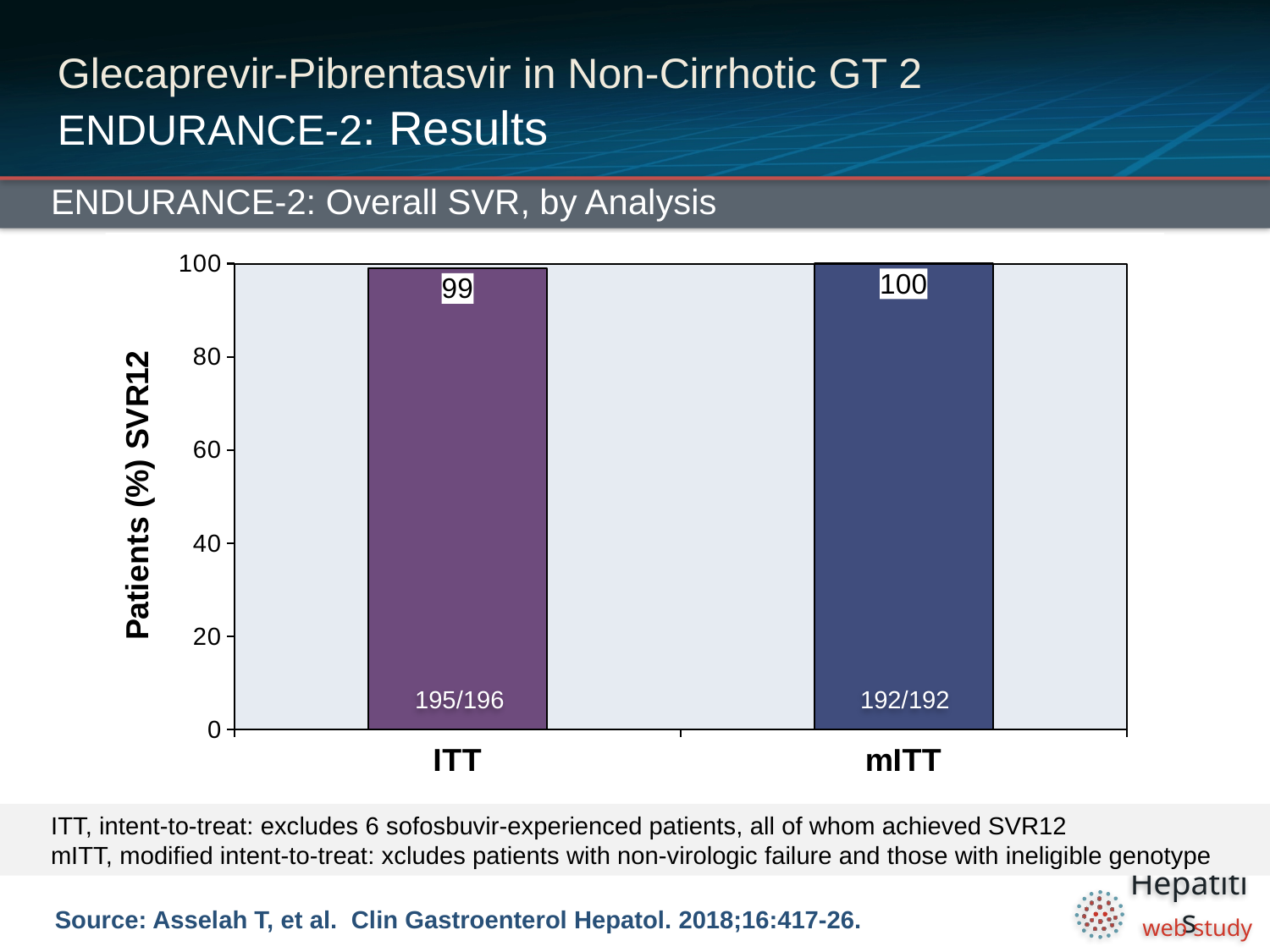
How many categories are shown on the x axis? 2 What kind of chart is shown? bar chart What fraction of patients is printed on the ITT bar? 195/196 Which analysis has the lower SVR12 value? ITT What fraction of patients is printed on the mITT bar? 192/192 Which analysis has the higher SVR12 value? mITT What is the SVR12 value for ITT? 99 Is the value for ITT greater or less than 80? greater What is the y-axis label of the chart? Patients (%) SVR12 What is the title of the chart? ENDURANCE-2: Overall SVR, by Analysis What is the difference between the mITT and ITT SVR12 values? 1 What is the SVR12 value for mITT? 100